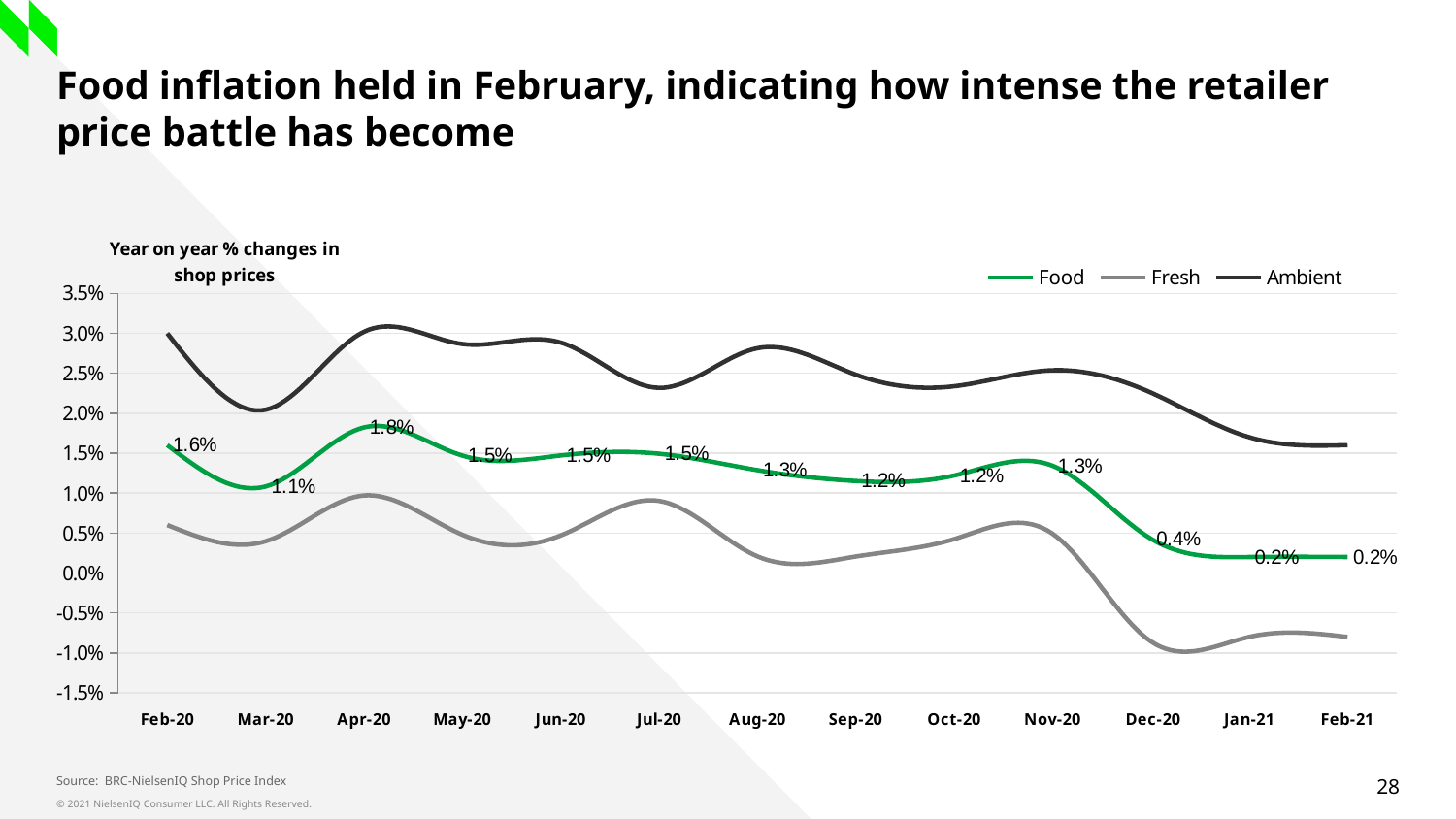
What kind of chart is shown on the slide? Line chart How many months are shown on the x axis? 13 What is the Food value for Dec-20? 0.4% What is the Food value for Feb-21? 0.2% Is the Ambient value for Jul-20 greater or less than 2.5%? less What is the lowest value shown for the Food series? 0.2% What is the difference between the Food value in Feb-20 and the Food value in Feb-21? 1.4 percentage points How many series does the legend list? 3 In which month does the Food series reach its highest value? Apr-20 What is the Food value for Apr-20? 1.8% Which is larger, the Food value for Mar-20 or the Food value for Apr-20? Apr-20 Is the Fresh value for Jan-21 greater or less than 0.0%? less